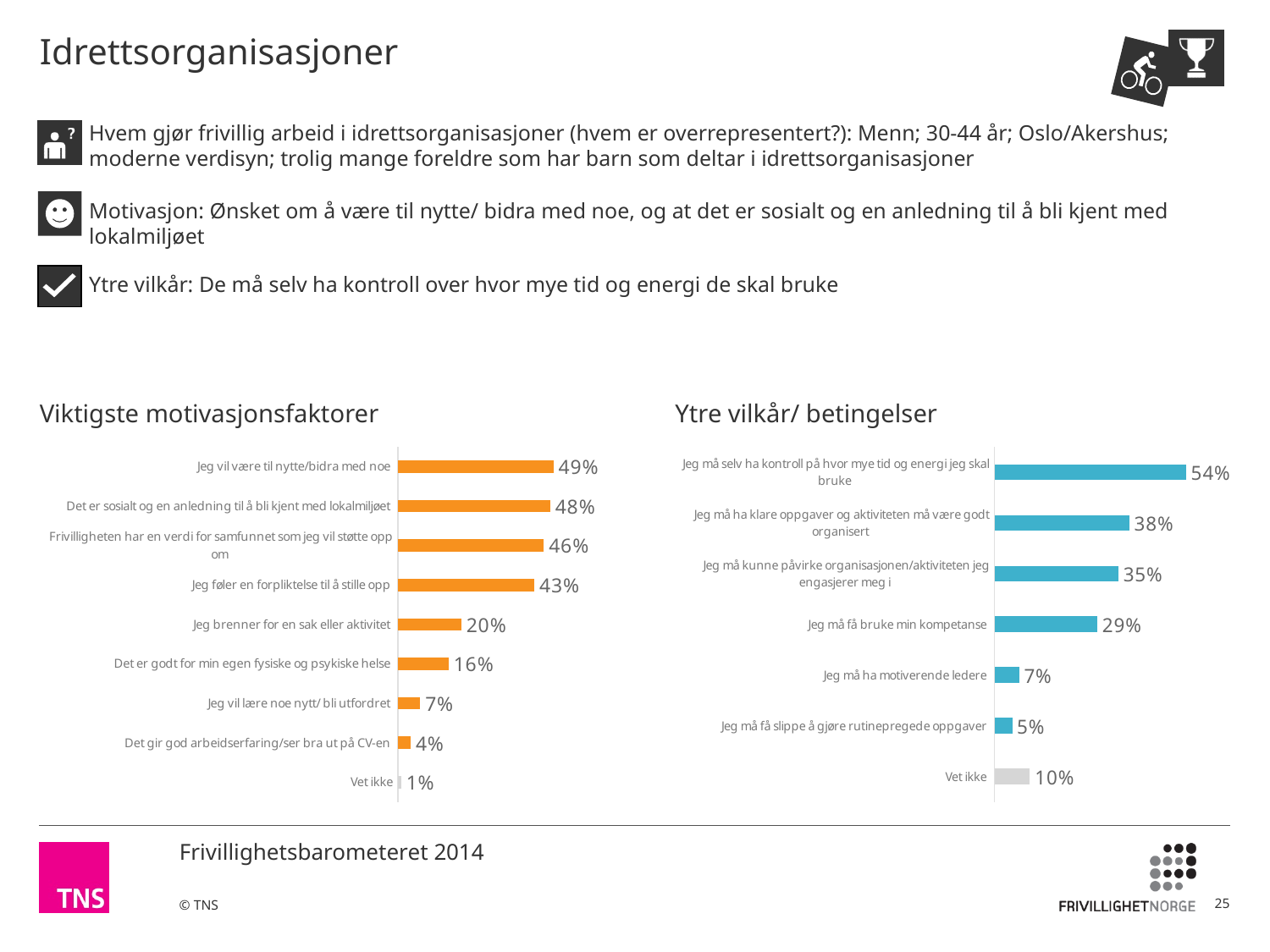
In the 'Ytre vilkår/ betingelser' chart, what is the difference between the top category and 'Jeg må ha klare oppgaver og aktiviteten må være godt organisert'? 16% In the 'Ytre vilkår/ betingelser' chart, which is larger: 'Jeg må ha motiverende ledere' or 'Vet ikke'? Vet ikke In the 'Viktigste motivasjonsfaktorer' chart, what is the value for 'Jeg vil være til nytte/bidra med noe'? 49% What type of chart is the 'Viktigste motivasjonsfaktorer' chart? Bar chart What colour are the bars in the 'Ytre vilkår/ betingelser' chart (excluding 'Vet ikke')? Blue In the 'Ytre vilkår/ betingelser' chart, how many categories are shown? 7 In the 'Ytre vilkår/ betingelser' chart, what is the value for 'Jeg må få bruke min kompetanse'? 29% In the 'Viktigste motivasjonsfaktorer' chart, how many categories are shown? 9 In the 'Viktigste motivasjonsfaktorer' chart, what is the difference between 'Jeg føler en forpliktelse til å stille opp' and 'Jeg brenner for en sak eller aktivitet'? 23% In the 'Ytre vilkår/ betingelser' chart, which category has the lowest value? Jeg må få slippe å gjøre rutinepregede oppgaver In the 'Viktigste motivasjonsfaktorer' chart, what is the value for 'Vet ikke'? 1% In the 'Viktigste motivasjonsfaktorer' chart, which category has the highest value? Jeg vil være til nytte/bidra med noe